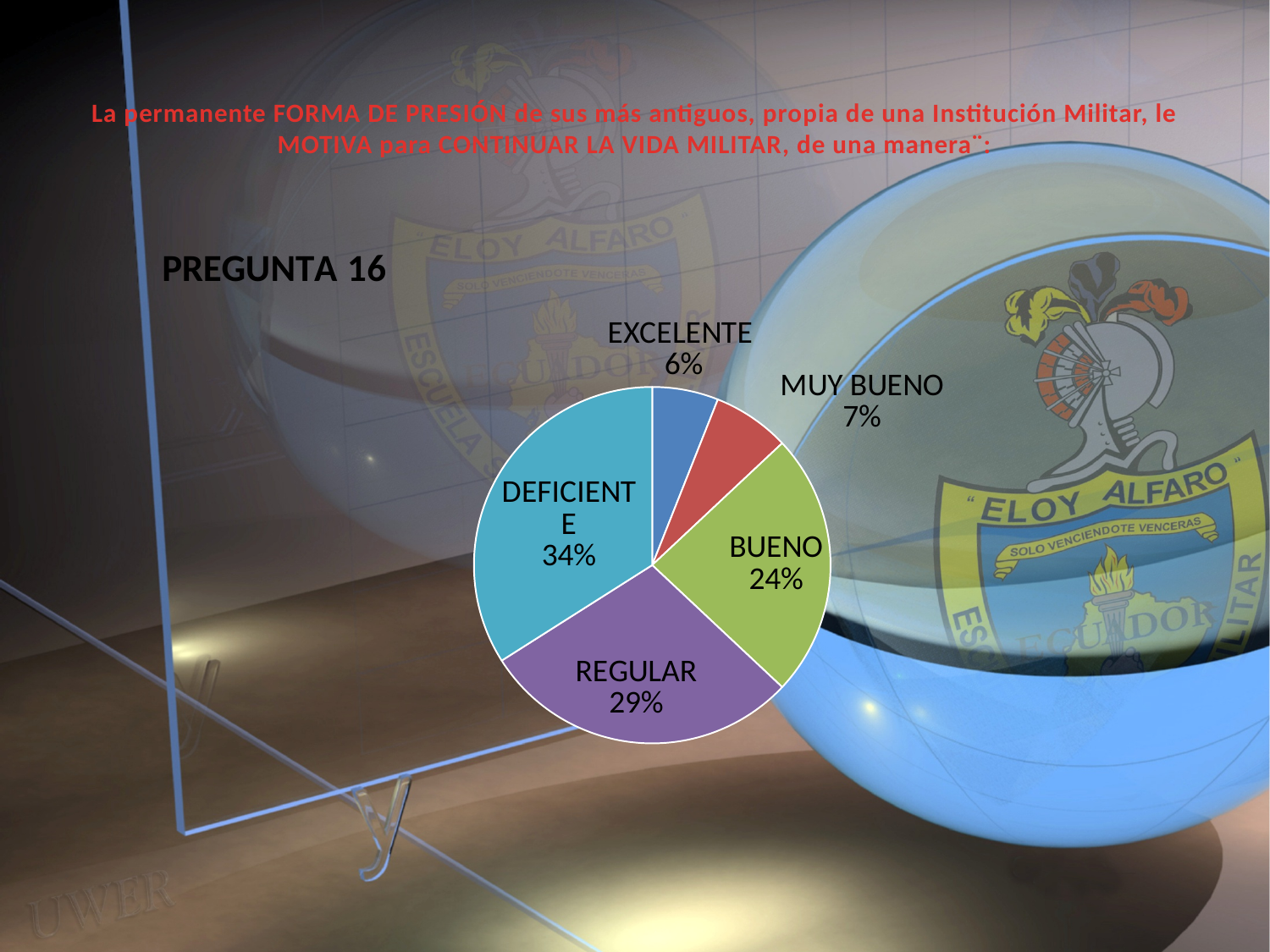
What percentage of the pie is labelled MUY BUENO? 7% Which is larger, the share for REGULAR or the share for BUENO? REGULAR Which category has the largest share of the pie? DEFICIENTE Which category has the smallest share of the pie? EXCELENTE What percentage of the pie is labelled BUENO? 24% What is the combined share of BUENO, MUY BUENO and EXCELENTE? 37% How many slices does the pie chart have? 5 What kind of chart is shown on the slide? pie chart What percentage of the pie is labelled REGULAR? 29% What percentage of the pie is labelled DEFICIENTE? 34% What percentage of the pie is labelled EXCELENTE? 6% What is the difference in percentage points between DEFICIENTE and BUENO? 10